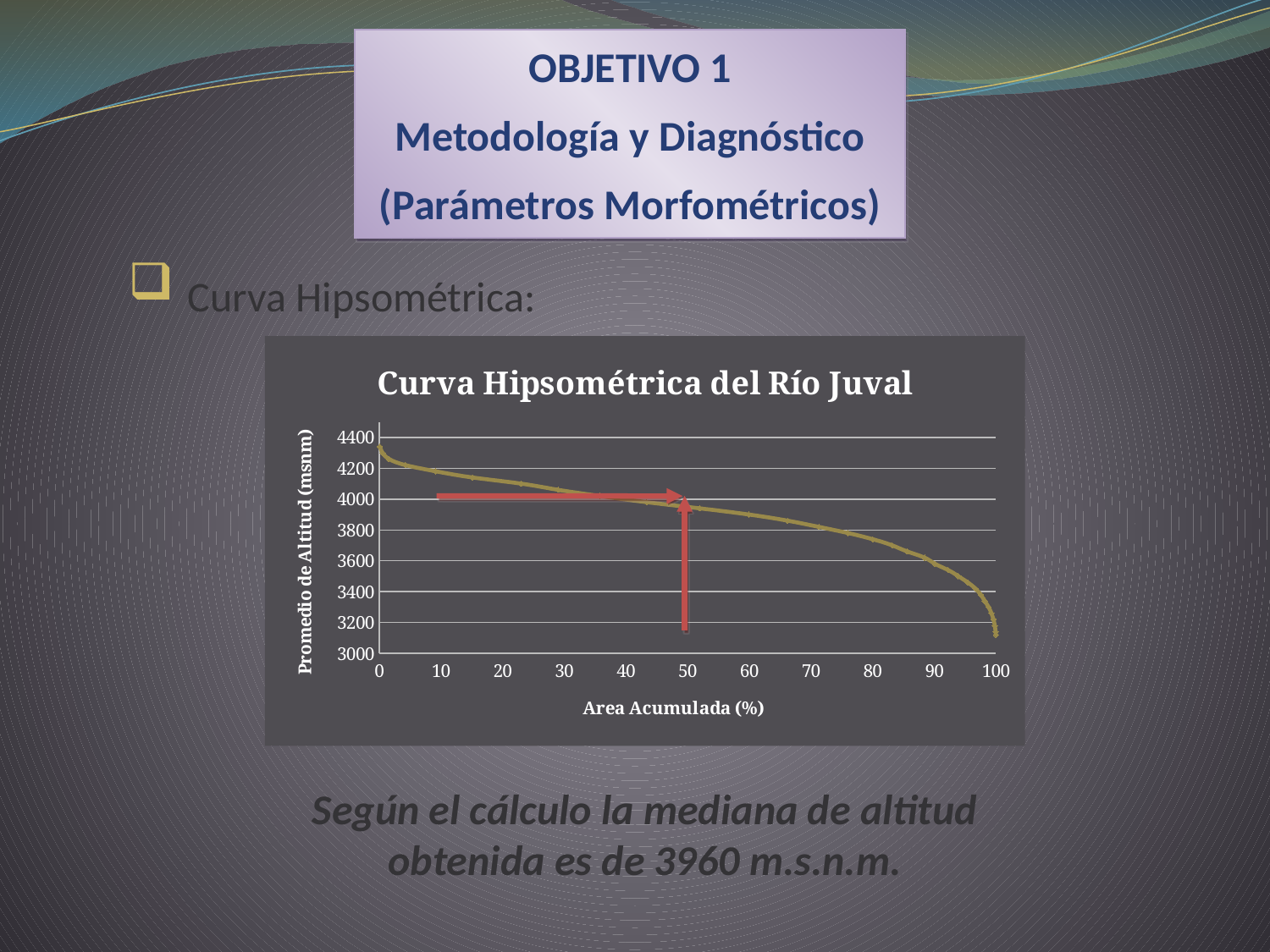
What is the label of the x axis of the chart? Area Acumulada (%) What is the highest tick value shown on the y axis of the chart? 4400 Which has the higher altitude on the curve: 10% or 90% accumulated area? 10% What kind of chart is shown on the slide? line chart Is the altitude value at 60% accumulated area greater or less than 3600? greater Is the altitude value at 0% accumulated area greater or less than 4200? greater Is the altitude value at 20% accumulated area greater or less than 4000? greater Does the altitude rise or fall as the accumulated area increases along the x axis? fall What is the title of the chart? Curva Hipsométrica del Río Juval